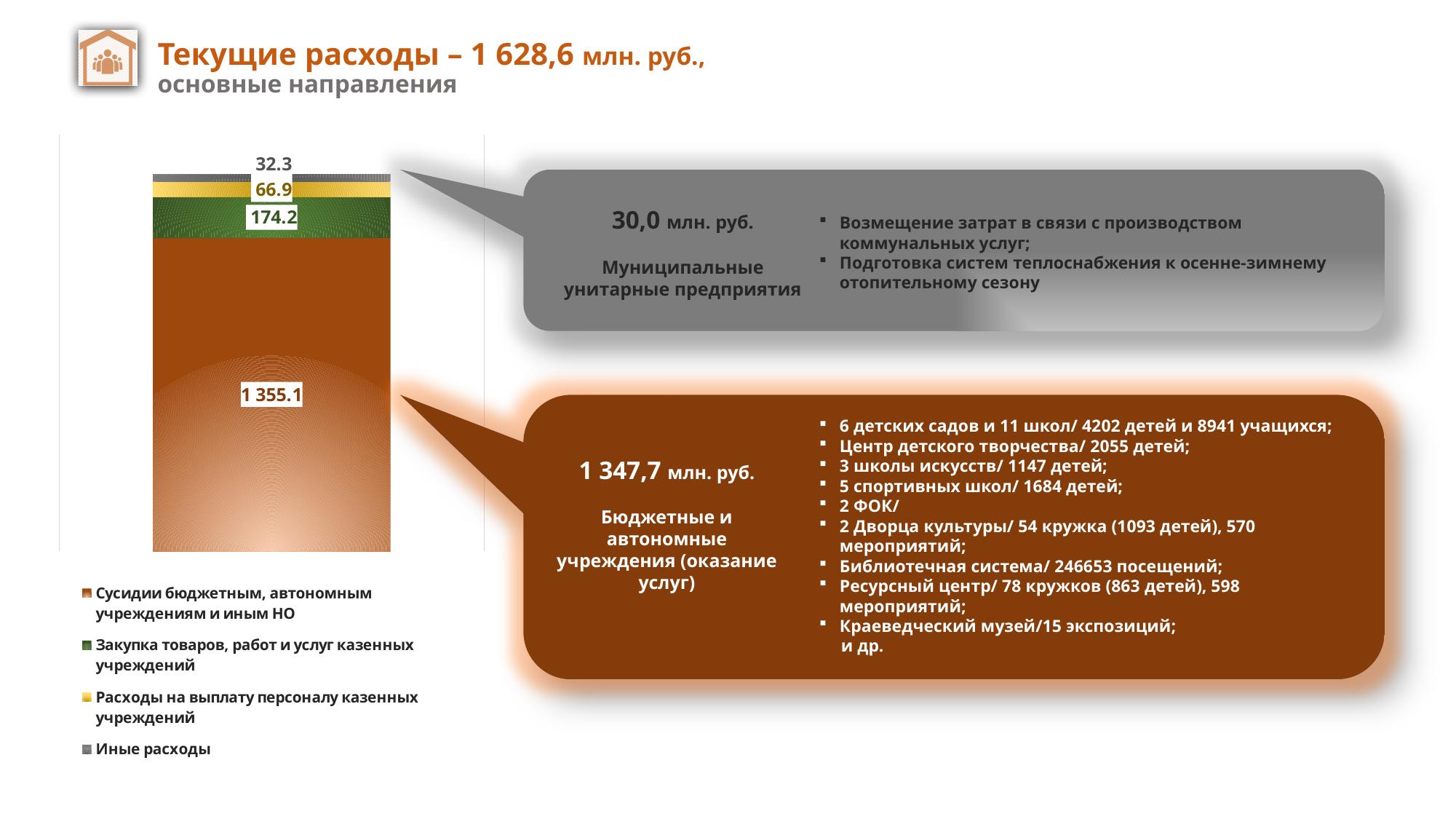
Which is larger: the 'Закупка товаров, работ и услуг казенных учреждений' segment or the 'Иные расходы' segment? Закупка товаров, работ и услуг казенных учреждений Which segment of the stacked bar has the largest value? Сусидии бюджетным, автономным учреждениям и иным НО What is the value of the segment for 'Закупка товаров, работ и услуг казенных учреждений'? 174.2 What is the value of the segment for 'Сусидии бюджетным, автономным учреждениям и иным НО'? 1 355.1 What is the value of the segment for 'Иные расходы'? 32.3 What type of chart is shown on the slide? Stacked bar chart How many series does the chart legend list? 4 What is the value of the segment for 'Расходы на выплату персоналу казенных учреждений'? 66.9 Which segment of the stacked bar has the smallest value? Иные расходы What is the difference between the 'Расходы на выплату персоналу казенных учреждений' segment and the 'Иные расходы' segment? 34.6 What colour is the segment for 'Закупка товаров, работ и услуг казенных учреждений'? Green What is the difference between the 'Закупка товаров, работ и услуг казенных учреждений' segment and the 'Расходы на выплату персоналу казенных учреждений' segment? 107.3